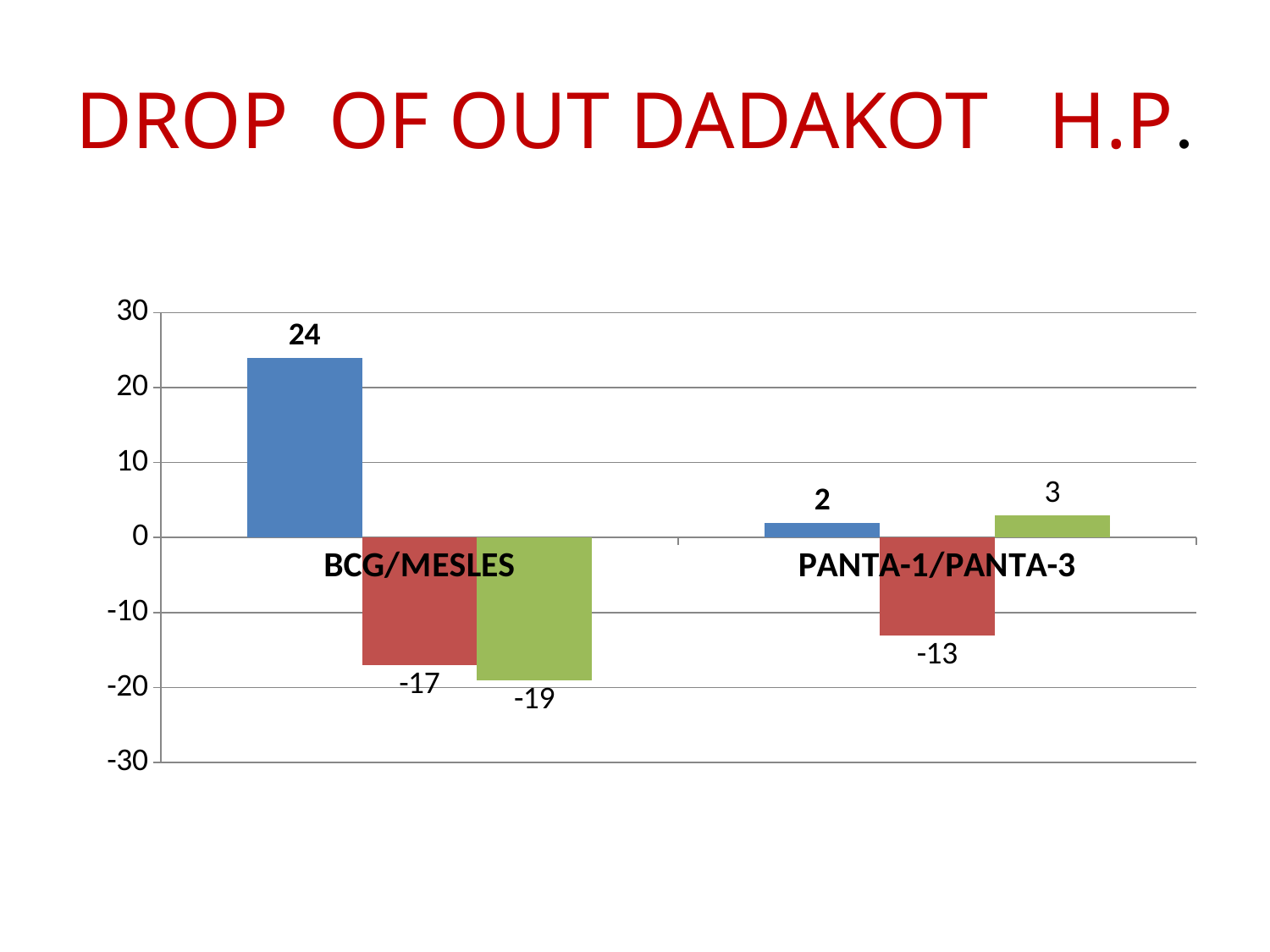
What is the value of the red bar for PANTA-1/PANTA-3? -13 How many categories are shown on the x axis of the chart? 2 What is the difference between the blue bar values for BCG/MESLES and PANTA-1/PANTA-3? 22 What is the value of the blue bar for PANTA-1/PANTA-3? 2 Which is larger, the red bar for BCG/MESLES or the red bar for PANTA-1/PANTA-3? the red bar for PANTA-1/PANTA-3 (-13) Which bar has the highest value in the chart? the blue bar for BCG/MESLES (24) What is the value of the red bar for BCG/MESLES? -17 What is the value of the green bar for BCG/MESLES? -19 What type of chart is shown on the slide? bar chart Which bar has the lowest value in the chart? the green bar for BCG/MESLES (-19) What is the value of the green bar for PANTA-1/PANTA-3? 3 What is the value of the blue bar for BCG/MESLES? 24